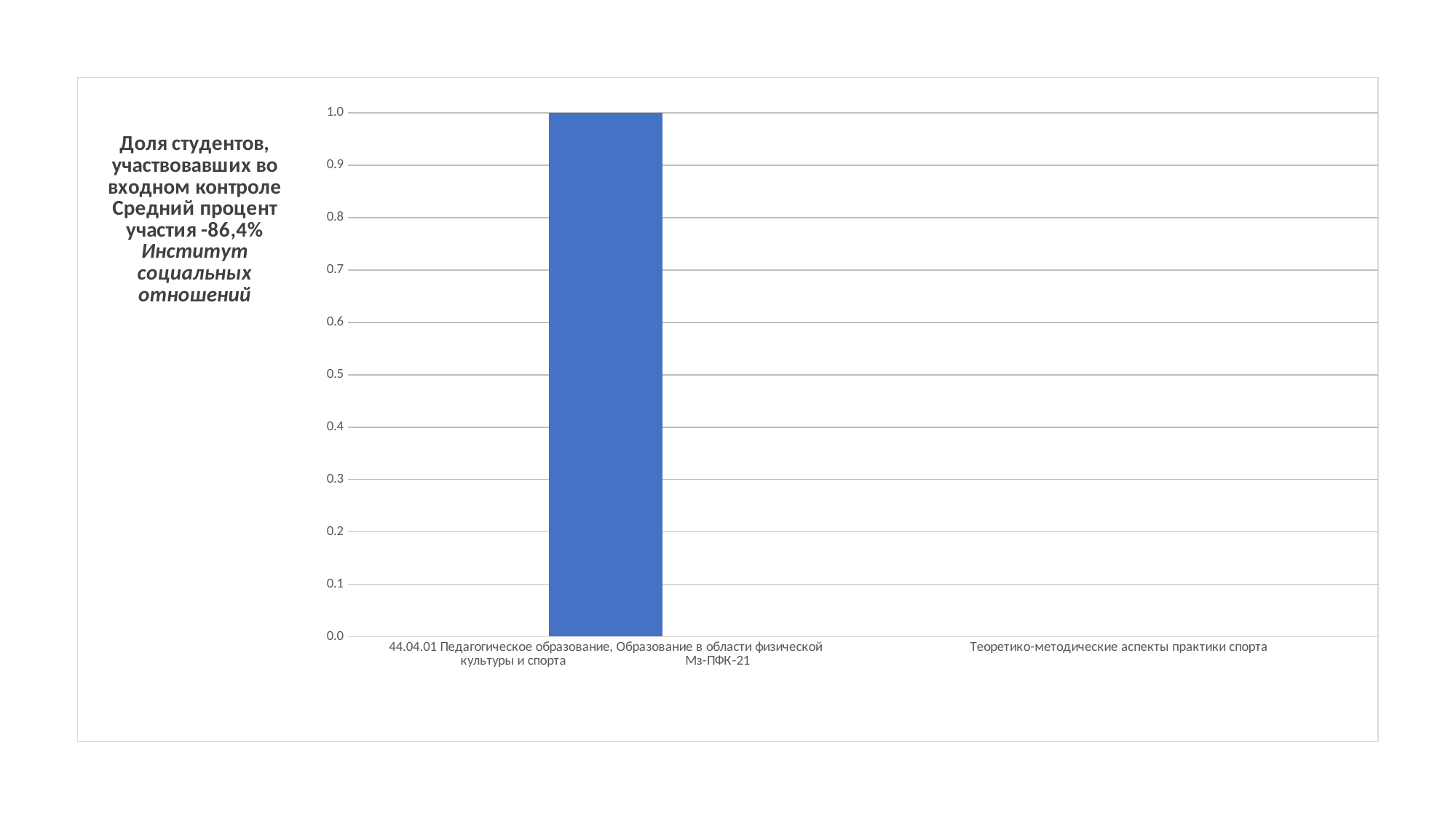
What is the highest value shown on the vertical axis? 1.0 What is the value of the bar for 44.04.01 Педагогическое образование, Образование в области физической культуры и спорта Мз-ПФК-21? 1.0 Is the value for 44.04.01 Педагогическое образование, Образование в области физической культуры и спорта Мз-ПФК-21 greater or less than 0.9? greater What average participation percentage is stated in the chart title? 86,4% Is the value for 44.04.01 Педагогическое образование, Образование в области физической культуры и спорта Мз-ПФК-21 greater or less than 0.5? greater Which category has the highest bar? 44.04.01 Педагогическое образование, Образование в области физической культуры и спорта Мз-ПФК-21 What kind of chart is shown on the slide? bar chart How many category labels are shown along the x axis? 2